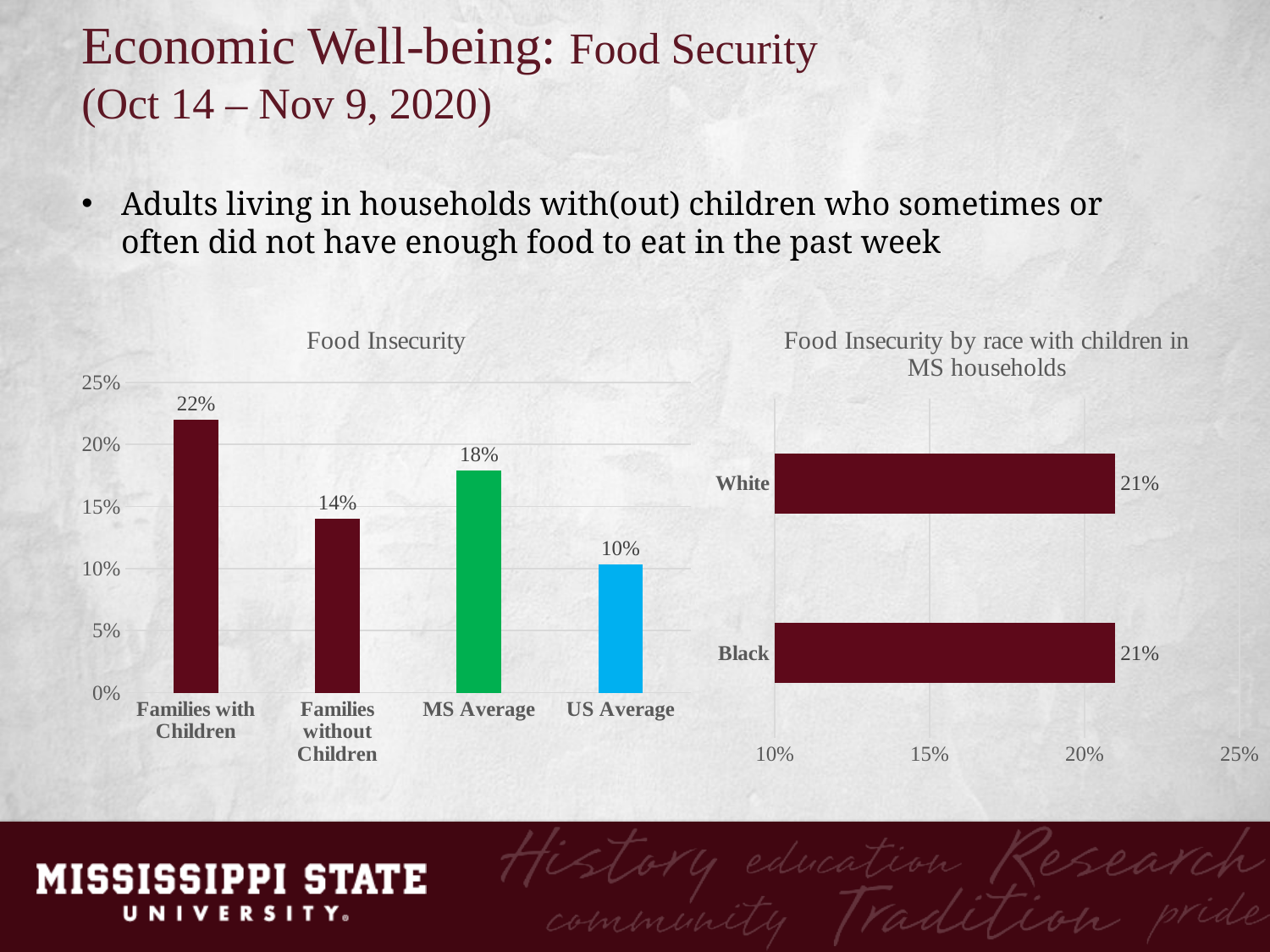
In the 'Food Insecurity' chart, which is larger, MS Average or US Average? MS Average What kind of chart is the 'Food Insecurity' chart? Bar chart In the 'Food Insecurity by race with children in MS households' chart, how many categories are shown? 2 In the 'Food Insecurity' chart, what is the value for Families with Children? 22% In the 'Food Insecurity by race with children in MS households' chart, what is the value for Black? 21% In the 'Food Insecurity' chart, which category has the lowest value? US Average In the 'Food Insecurity' chart, what colour is the MS Average bar? Green In the 'Food Insecurity' chart, what is the difference between Families with Children and Families without Children? 8% In the 'Food Insecurity by race with children in MS households' chart, what is the value for White? 21% In the 'Food Insecurity' chart, what is the value for US Average? 10% In the 'Food Insecurity' chart, which category has the highest value? Families with Children In the 'Food Insecurity' chart, how many categories are shown? 4